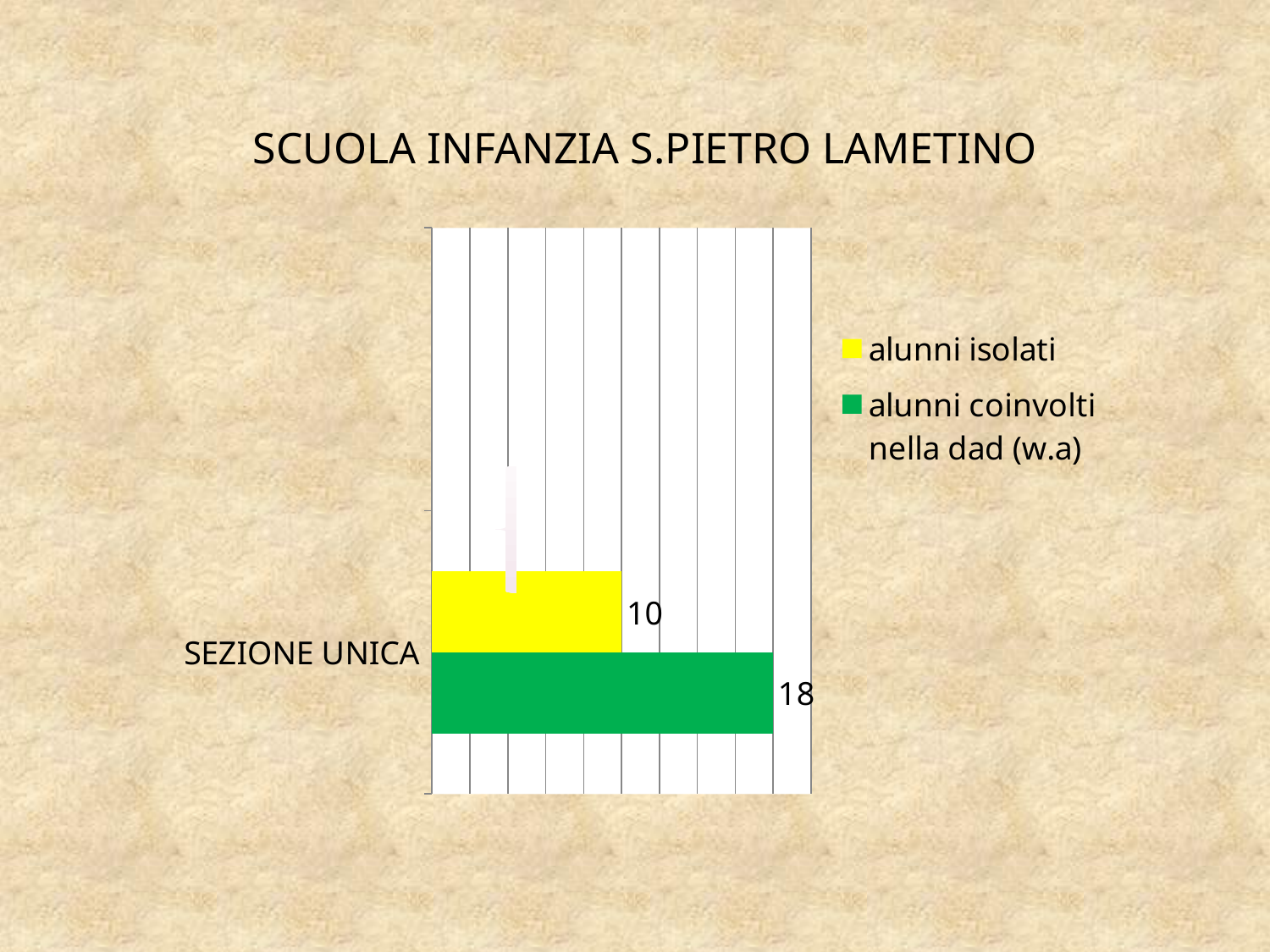
What is the title of the slide? SCUOLA INFANZIA S.PIETRO LAMETINO How many categories are shown on the chart? 1 Which series has the lower value for SEZIONE UNICA? alunni isolati What is the value for 'alunni isolati' for SEZIONE UNICA? 10 How many series does the legend list? 2 Which colour represents 'alunni isolati' in the chart? yellow Is the value for 'alunni isolati' larger or smaller than the value for 'alunni coinvolti nella dad (w.a)'? smaller Which series has the higher value for SEZIONE UNICA? alunni coinvolti nella dad (w.a) What kind of chart is shown on the slide? bar chart What is the difference between 'alunni coinvolti nella dad (w.a)' and 'alunni isolati' for SEZIONE UNICA? 8 What is the value for 'alunni coinvolti nella dad (w.a)' for SEZIONE UNICA? 18